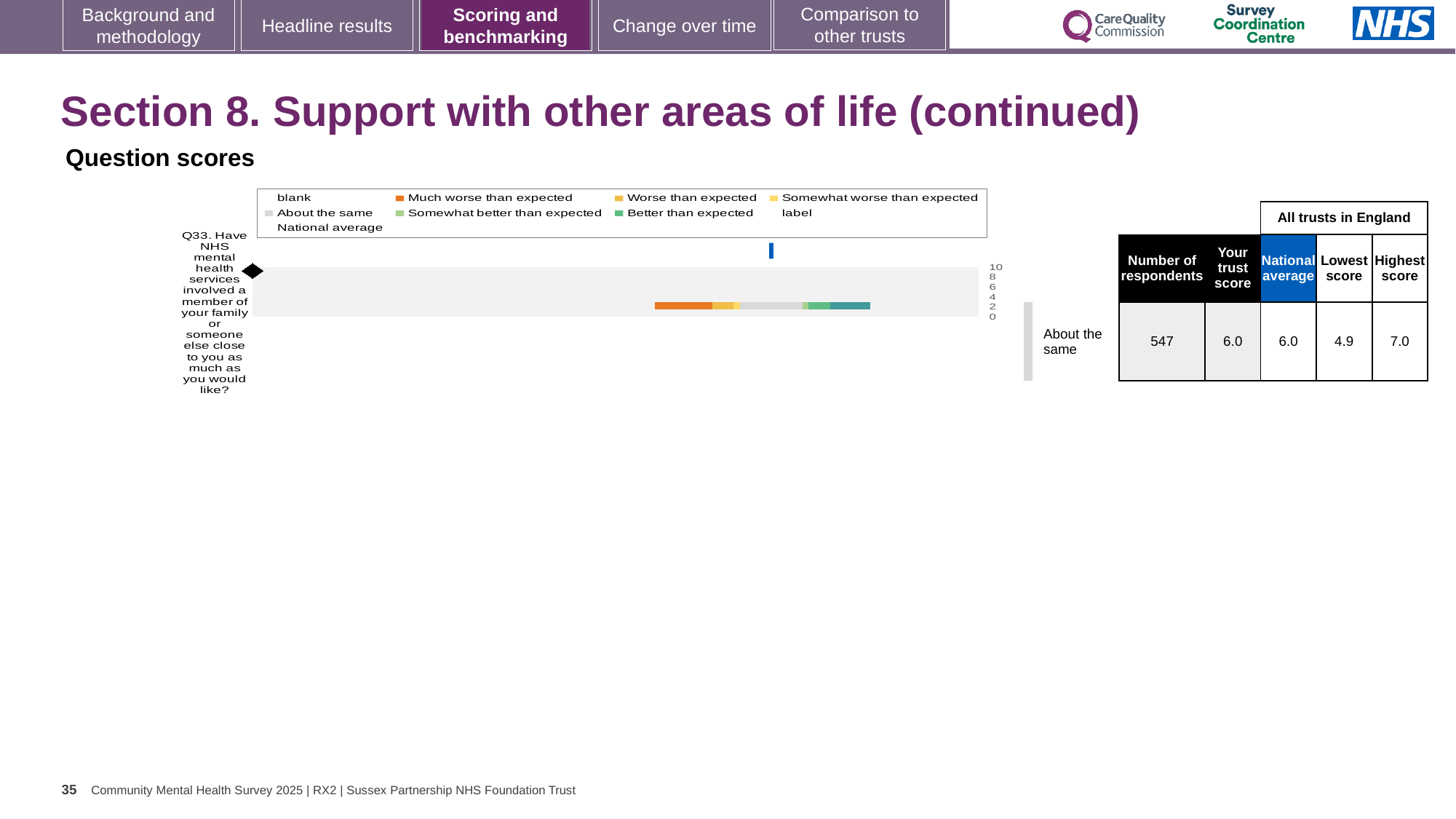
Which question number is plotted in the chart? Q33 What is the highest score among all trusts in England for Q33? 7.0 What is the number of respondents for Q33? 547 What is the national average score for Q33? 6.0 What is the lowest score among all trusts in England for Q33? 4.9 What is the difference between the trust's score and the lowest score for Q33? 1.1 What kind of chart is shown on the slide? bar chart What benchmark category is the trust's Q33 score placed in? About the same What is the trust's score for Q33? 6.0 Is the trust's score for Q33 higher than, lower than, or the same as the national average? the same How many survey questions are plotted in the chart? 1 What is the difference between the highest and lowest scores for Q33 among all trusts in England? 2.1